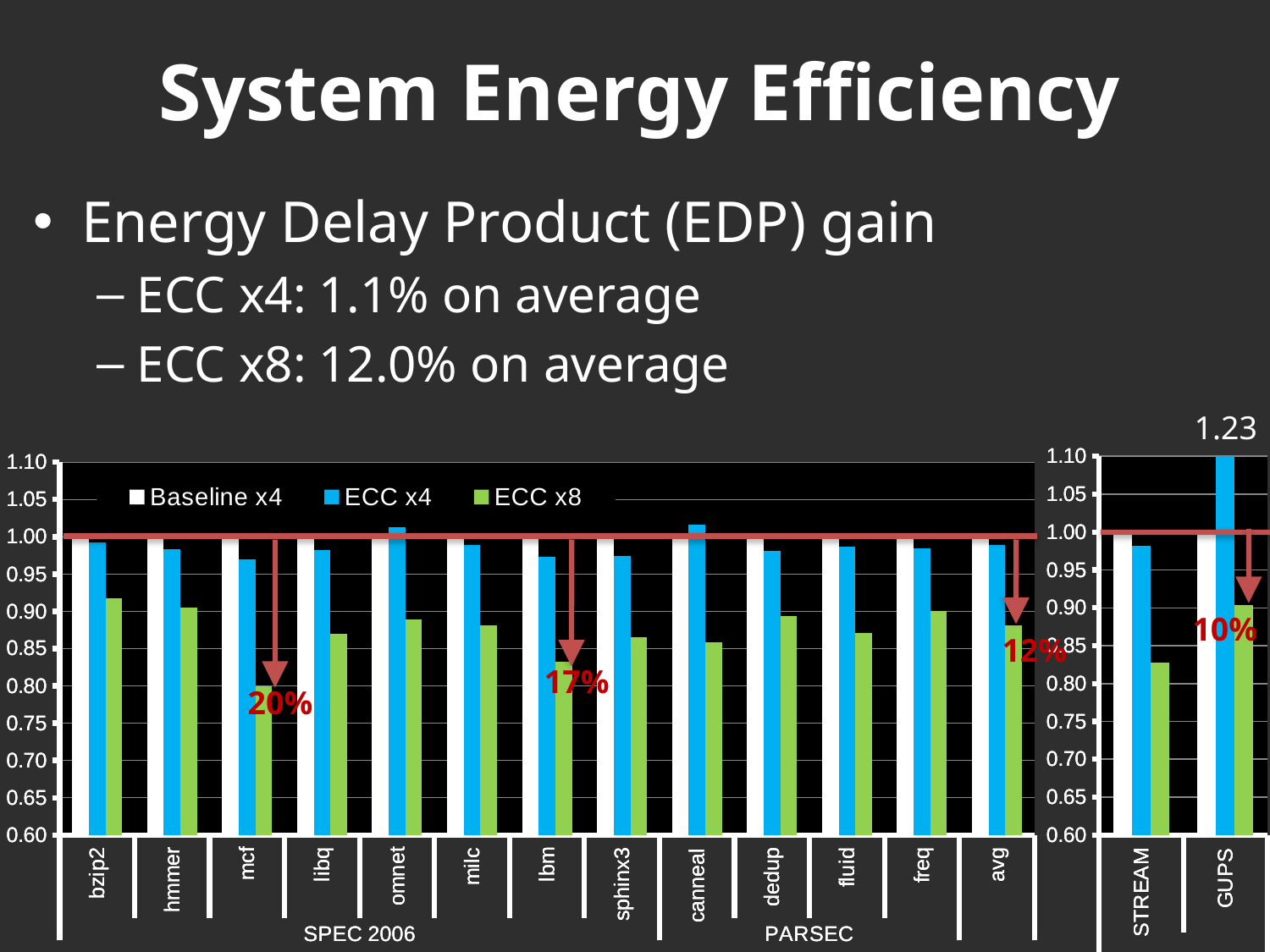
In the left chart, is the ECC x8 value for canneal greater or less than 0.90? less In the right chart, what percentage gain is annotated for GUPS? 10% Which colour represents the ECC x8 series in the legend? green In the left chart, which benchmark has the lowest ECC x8 value? mcf In the left chart, what percentage gain is annotated for lbm? 17% How many series does the legend of the left chart list? 3 In the left chart, what percentage gain is annotated for mcf? 20% How many benchmark categories are shown on the x axis of the left chart (SPEC 2006 and PARSEC)? 13 In the right chart, what is the ECC x4 value for GUPS? 1.23 What kind of chart is shown on the slide? bar chart How many categories are shown in the right chart? 2 In the left chart, is the ECC x4 value for canneal greater or less than 1.00? greater